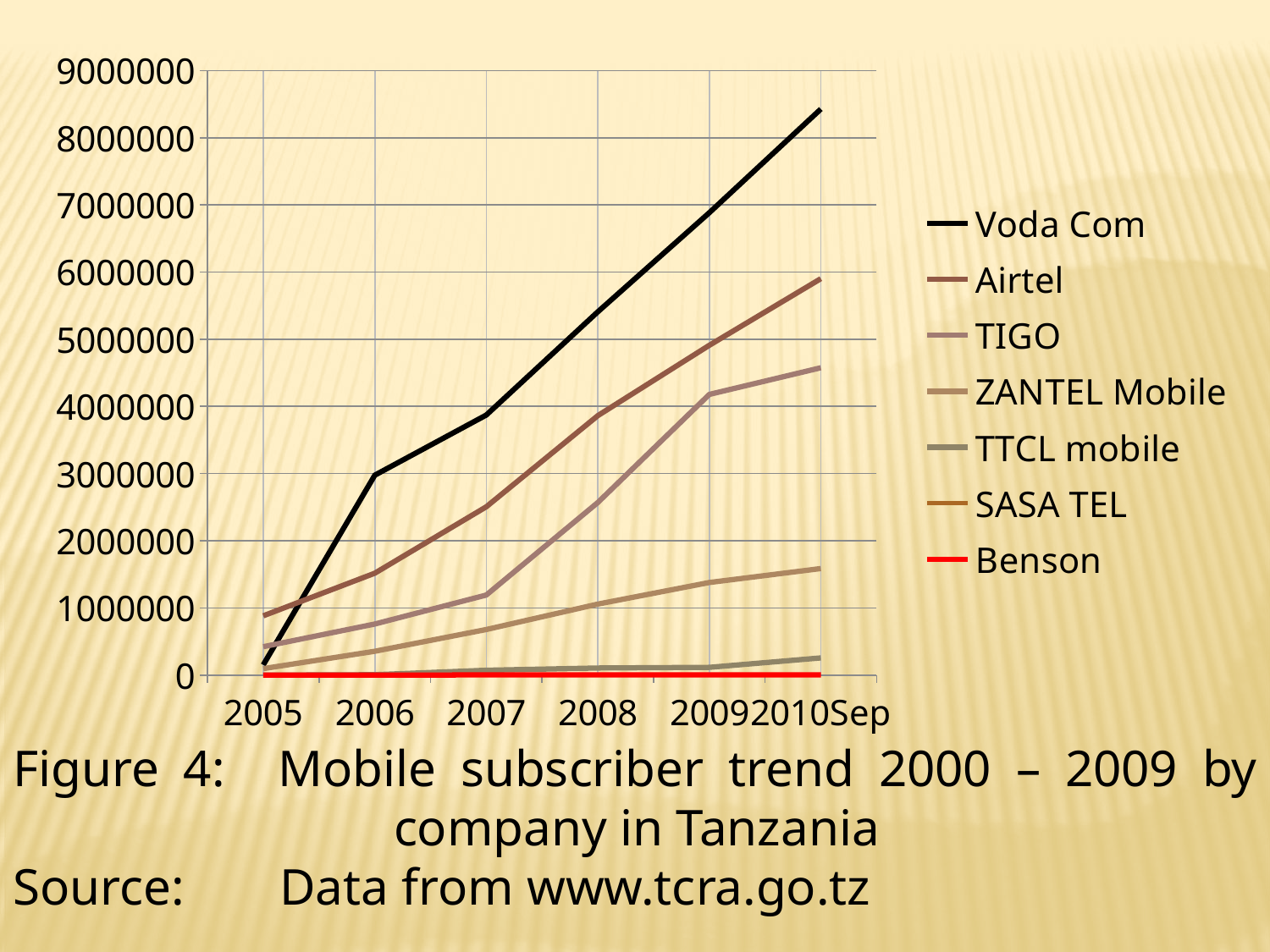
Is the value for ZANTEL Mobile at 2010Sep greater or less than 1000000? greater Which company has the highest number of subscribers at 2010Sep? Voda Com Is the value for Voda Com at 2010Sep greater or less than 8000000? greater In 2008, which has more subscribers, Airtel or TIGO? Airtel Does the Voda Com line rise or fall from 2005 to 2010Sep? Rises What kind of chart is shown on the slide? Line chart In 2005, which has more subscribers, Voda Com or Airtel? Airtel How many series does the legend list? 7 Which company has the lowest number of subscribers across the whole period? Benson Is the value for TIGO at 2010Sep greater or less than 4000000? greater How many time points are shown along the x axis? 6